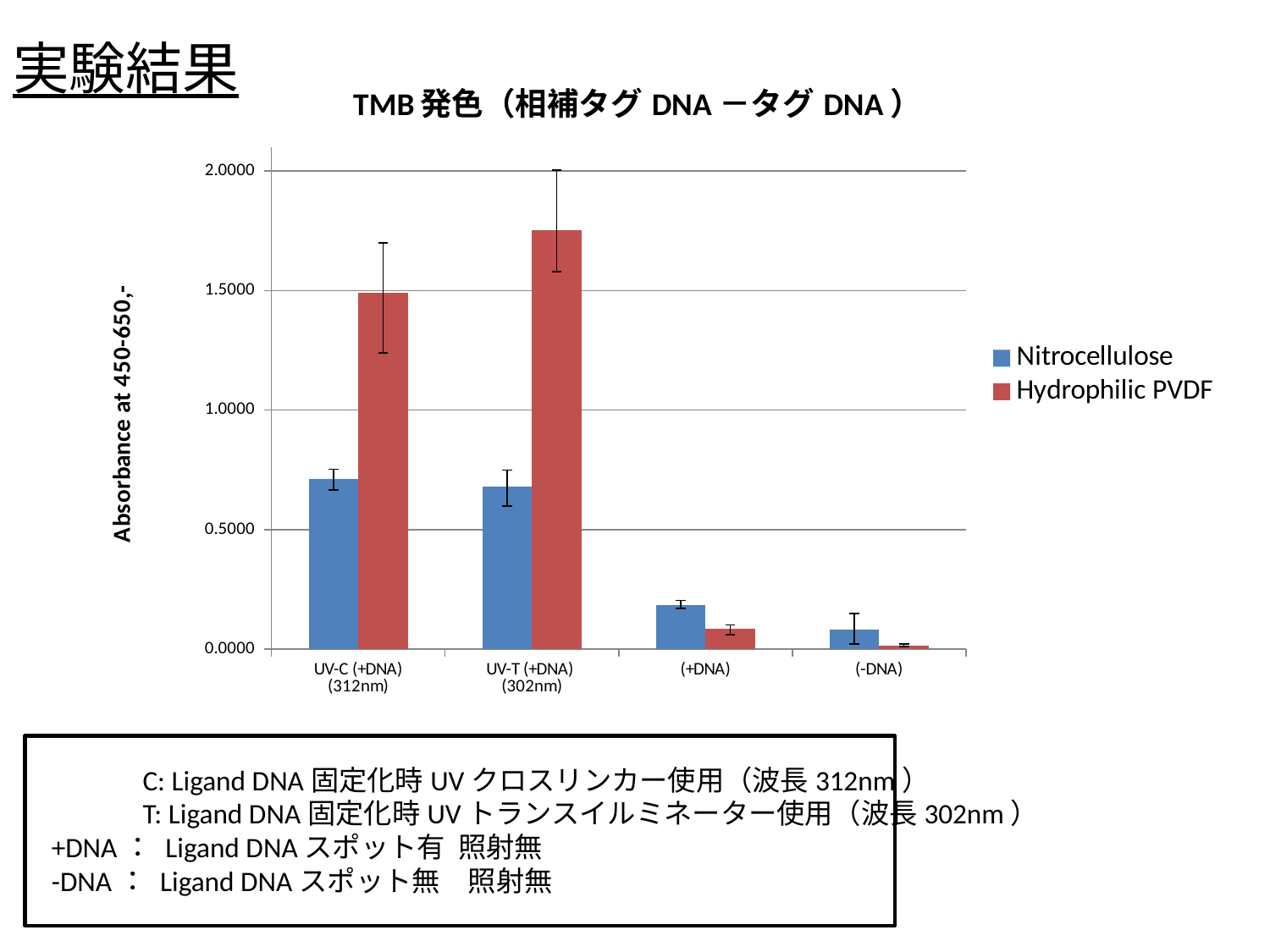
Is the Hydrophilic PVDF value for UV-T (+DNA) (302nm) greater or less than 1.5000? greater Which category has the lowest Hydrophilic PVDF value? (-DNA) Which category has the lowest Nitrocellulose value? (-DNA) Is the Hydrophilic PVDF value for UV-C (+DNA) (312nm) greater or less than 1.0000? greater For UV-C (+DNA) (312nm), which series has the larger value, Nitrocellulose or Hydrophilic PVDF? Hydrophilic PVDF Is the Nitrocellulose value for UV-C (+DNA) (312nm) greater or less than 1.0000? less What is the label of the y axis? Absorbance at 450-650,- How many series does the legend list? 2 Which category has the highest Hydrophilic PVDF value? UV-T (+DNA) (302nm) For (+DNA), which series has the larger value, Nitrocellulose or Hydrophilic PVDF? Nitrocellulose How many categories are shown on the x axis? 4 What kind of chart is shown on the slide? bar chart